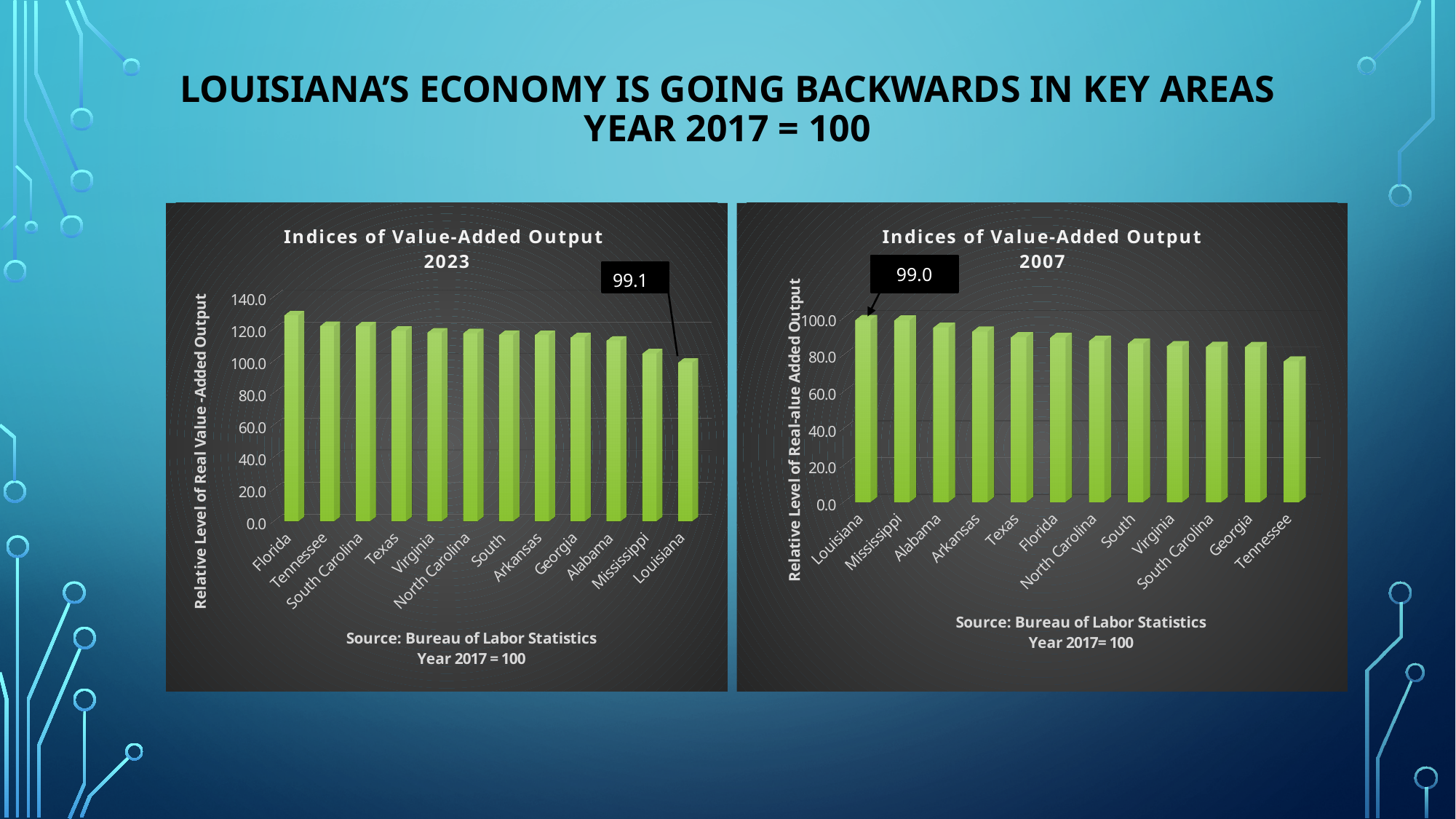
In the 2007 chart on the right, is the value for Tennessee greater or less than 100? less In the 2023 chart on the left, is the value for Florida greater or less than 120? greater How many states or regions are shown in the 2023 chart on the left? 12 In the 2023 chart on the left, which state has the lowest value? Louisiana In the 2007 chart on the right, what is the value for Louisiana? 99.0 In the 2023 chart on the left, do the values rise or fall from left to right along the x axis? fall In the 2007 chart on the right, which state has the lowest value? Tennessee What kind of chart is the 2007 chart on the right? bar chart In the 2007 chart on the right, which is larger, the value for Louisiana or the value for Tennessee? Louisiana In the 2023 chart on the left, what is the value for Louisiana? 99.1 In the 2023 chart on the left, which is larger, the value for Florida or the value for Mississippi? Florida In the 2023 chart on the left, which state has the highest value? Florida